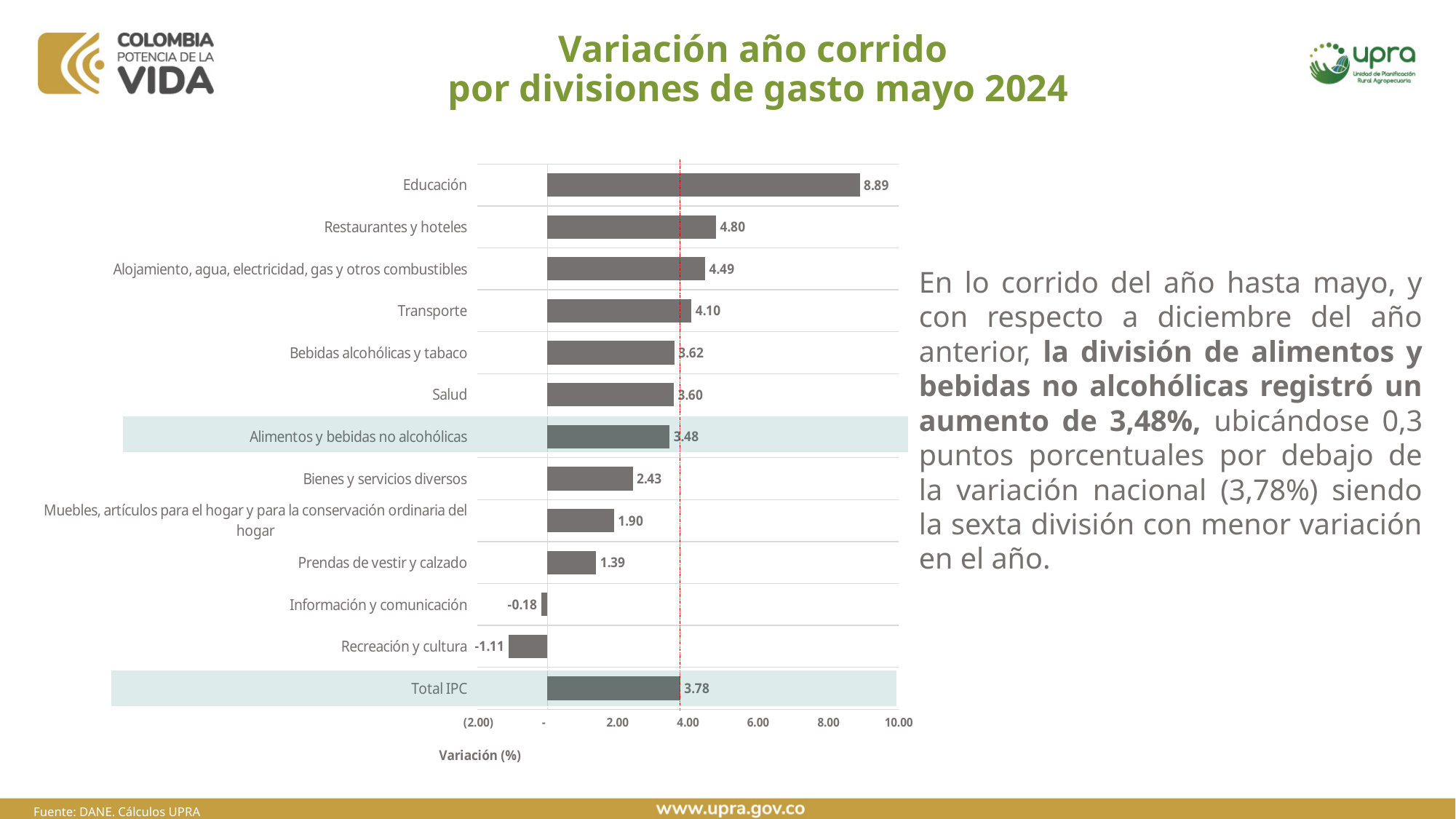
Which category has the lowest value? Recreación y cultura How many bars are shown in the chart? 13 What is the value for Recreación y cultura? -1.11 What kind of chart is shown on the slide? bar chart What is the title of the horizontal axis? Variación (%) Which is larger, the value for Transporte or the value for Salud? Transporte What is the value for Alimentos y bebidas no alcohólicas? 3.48 What is the difference between the values for Educación and Restaurantes y hoteles? 4.09 Is the value for Educación greater or less than 8.00? greater What is the value for Educación? 8.89 What is the value for Total IPC? 3.78 Which category has the highest value? Educación